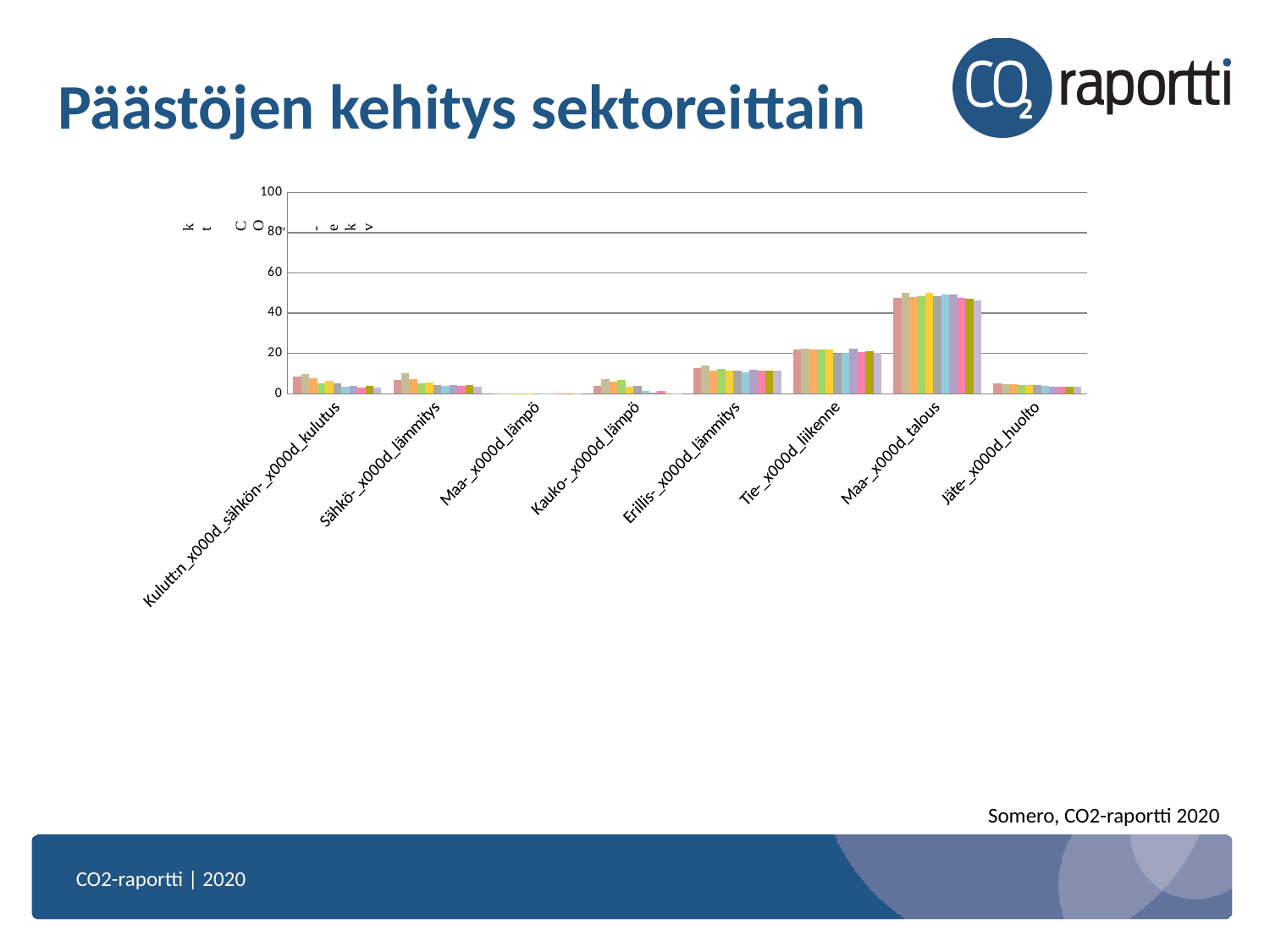
What is the title of the slide containing the chart? Päästöjen kehitys sektoreittain Are the values for Jäte-_x000d_huolto greater or less than 20? less Which category has the highest bars in the chart? Maa-_x000d_talous Which category has the lowest bars in the chart? Maa-_x000d_lämpö What is the highest tick value shown on the y axis of the chart? 100 How many categories are shown on the x axis of the chart? 8 Are the values for Tie-_x000d_liikenne greater or less than 40? less Are the values for Maa-_x000d_talous greater or less than 40? greater What kind of chart is shown on the slide? bar chart Which category has larger values, Maa-_x000d_talous or Tie-_x000d_liikenne? Maa-_x000d_talous Which category has larger values, Tie-_x000d_liikenne or Erillis-_x000d_lämmitys? Tie-_x000d_liikenne